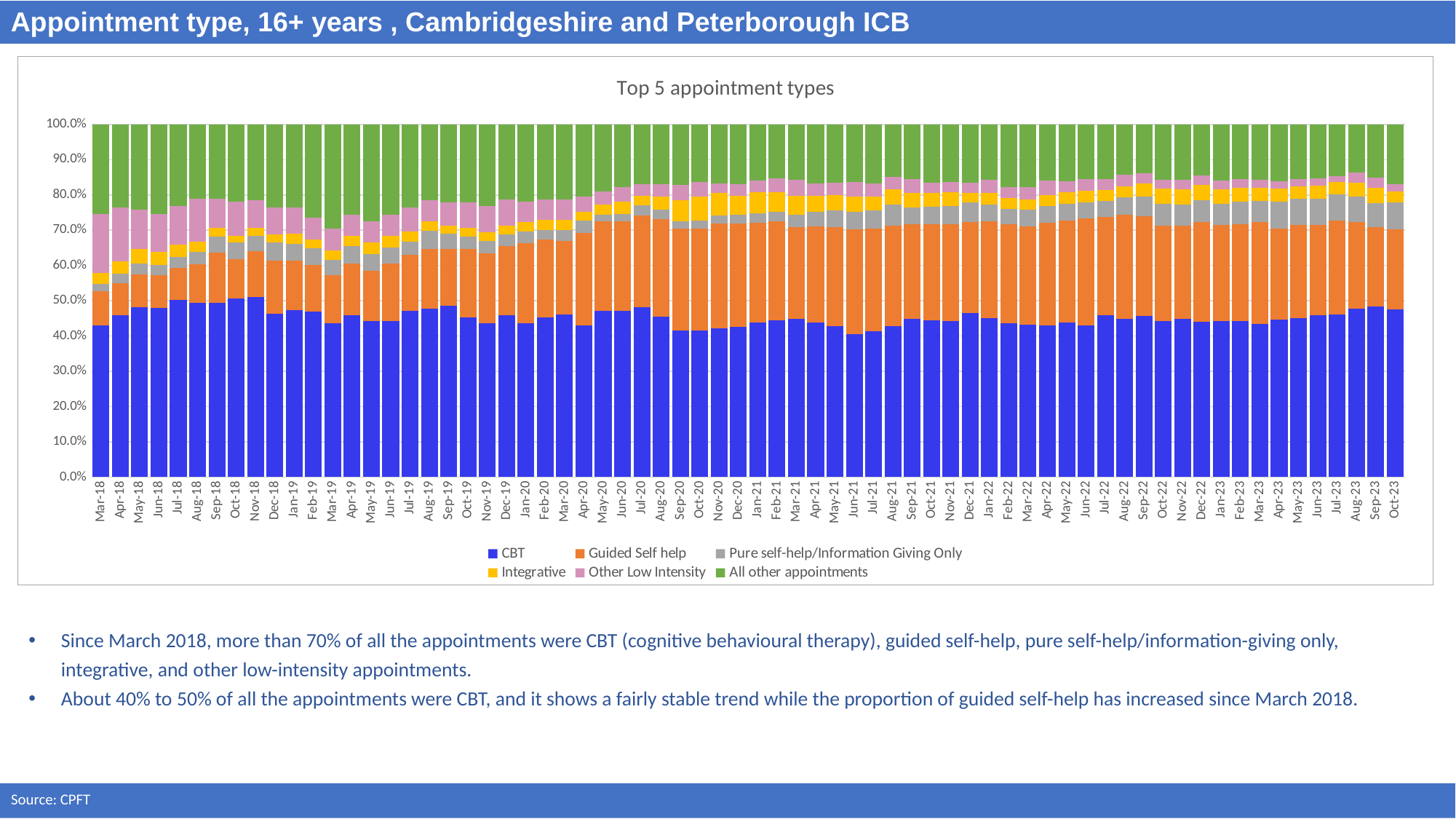
What is the title of the chart? Top 5 appointment types Is the CBT share for Jun-21 greater or less than 50.0%? less Is the CBT share for Oct-23 greater or less than 50.0%? less How many months are plotted along the x axis, from Mar-18 to Oct-23? 68 What kind of chart is shown on the slide? Stacked bar chart Which series is shown in blue in the legend? CBT What is the total of each stacked bar in the chart? 100.0% Is the CBT share for Mar-18 greater or less than 40.0%? greater What is the first month shown on the x axis? Mar-18 How many series does the legend list? 6 Does the share of Other Low Intensity appointments rise or fall from Mar-18 to Oct-23? fall Does the share of Guided Self help rise or fall from Mar-18 to Oct-23? rise